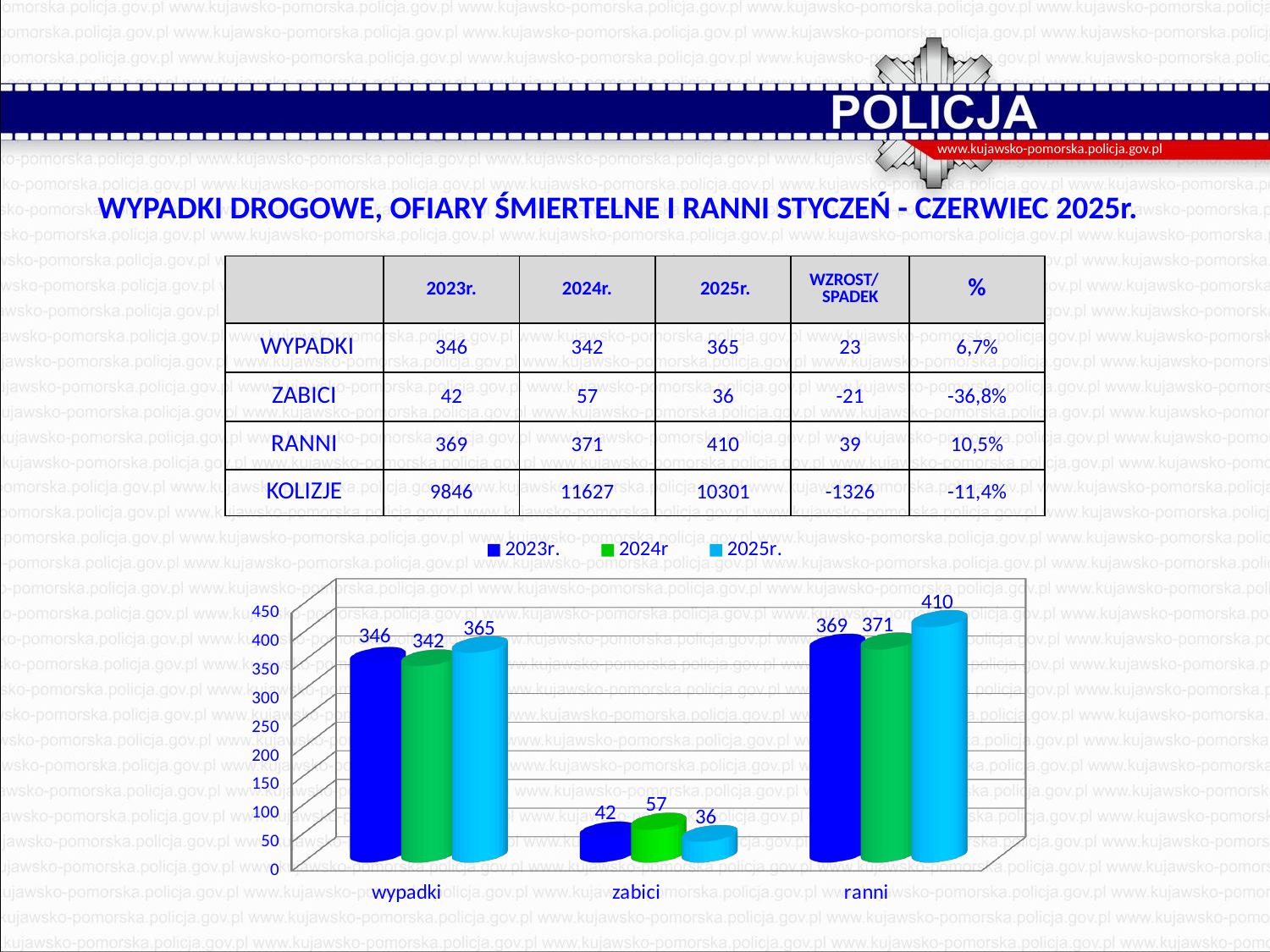
What kind of chart is shown on the slide? bar chart What is the value for ranni in the 2023r. series? 369 How many categories are shown on the x axis of the chart? 3 What is the difference between the 2025r. and 2024r values for ranni? 39 Is the value for ranni in 2025r. greater or less than 400? greater How many series does the chart legend list? 3 What is the value for wypadki in the 2025r. series? 365 Which category has the highest value in the 2025r. series? ranni Which category has the lowest value in the 2023r. series? zabici Which is larger for zabici: the 2024r value or the 2025r. value? 2024r What is the value for zabici in the 2024r series? 57 What is the difference between the 2024r and 2025r. values for zabici? 21